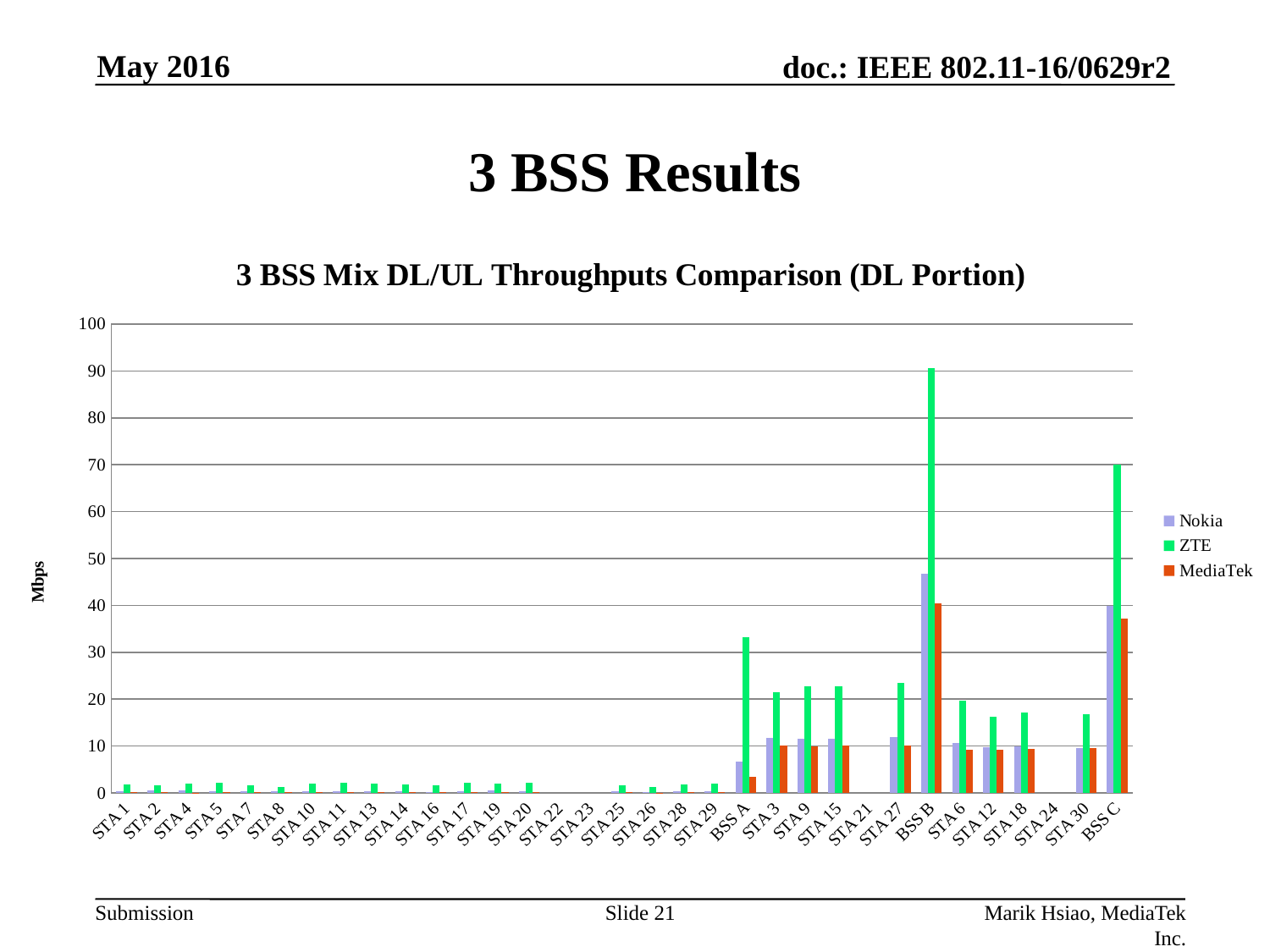
For BSS B, which series has the larger value, ZTE or Nokia? ZTE Which series are listed in the legend? Nokia, ZTE, MediaTek How many series does the legend list? 3 What unit is shown on the vertical axis? Mbps Is the ZTE value for BSS A greater or less than 30? greater Which has the larger ZTE value, BSS B or BSS C? BSS B What type of chart is shown on the slide? bar chart What is the title of the chart? 3 BSS Mix DL/UL Throughputs Comparison (DL Portion) Is the ZTE value for BSS B greater or less than 80? greater Is the MediaTek value for BSS C greater or less than 40? less For which category is the ZTE value highest? BSS B